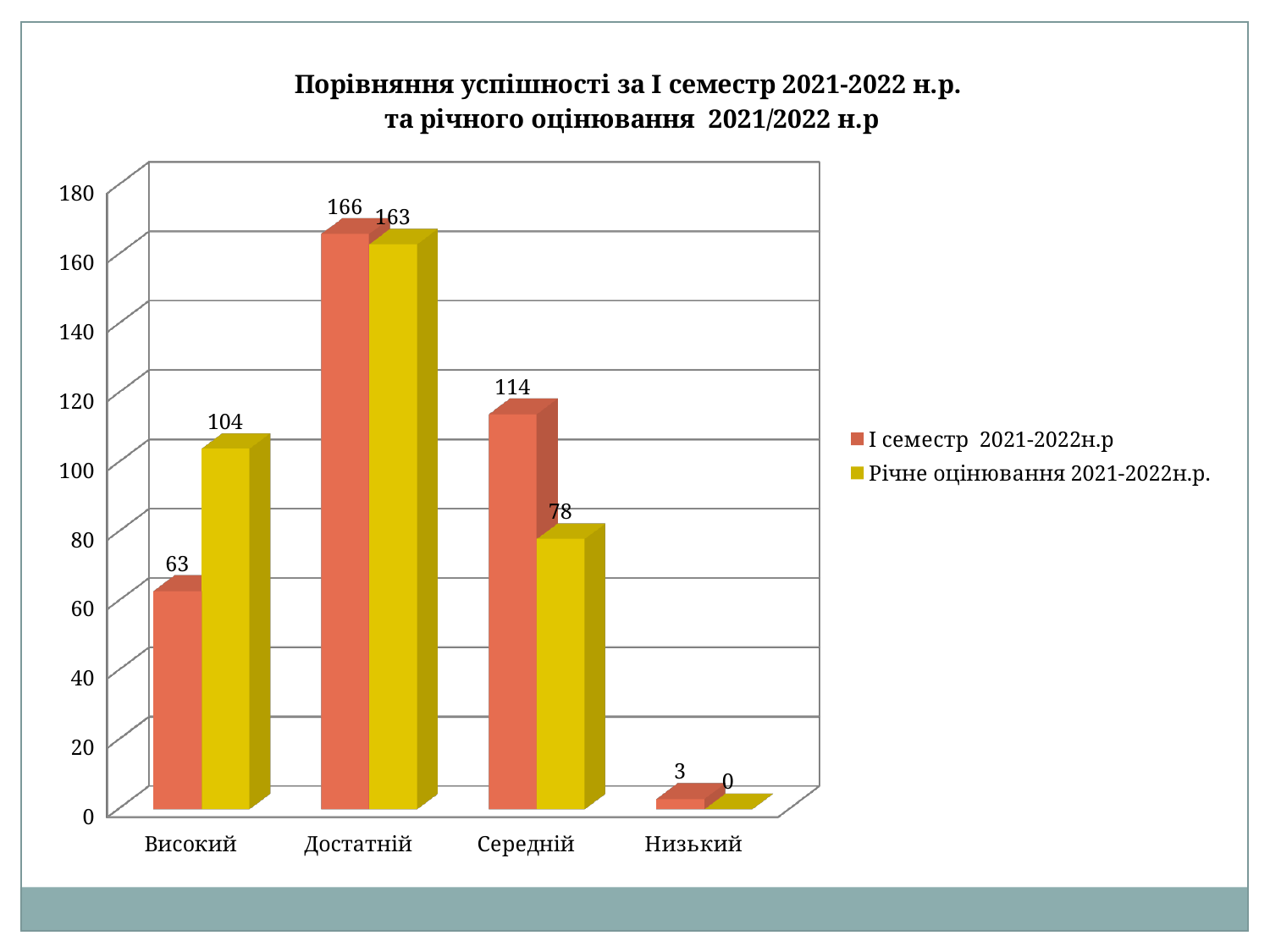
What is the value for Високий in the І семестр 2021-2022н.р series? 63 Which category has the highest value in the І семестр 2021-2022н.р series? Достатній For Високий, which series has the larger value: І семестр 2021-2022н.р or Річне оцінювання 2021-2022н.р.? Річне оцінювання 2021-2022н.р. How many series does the legend list? 2 Which category has the lowest value in the Річне оцінювання 2021-2022н.р. series? Низький What is the difference between the І семестр and Річне оцінювання values for Достатній? 3 What kind of chart is shown on the slide? Bar chart What is the value for Низький in the І семестр 2021-2022н.р series? 3 How many categories are shown on the x axis? 4 What is the difference between the І семестр and Річне оцінювання values for Середній? 36 What is the value for Середній in the Річне оцінювання 2021-2022н.р. series? 78 What is the value for Високий in the Річне оцінювання 2021-2022н.р. series? 104